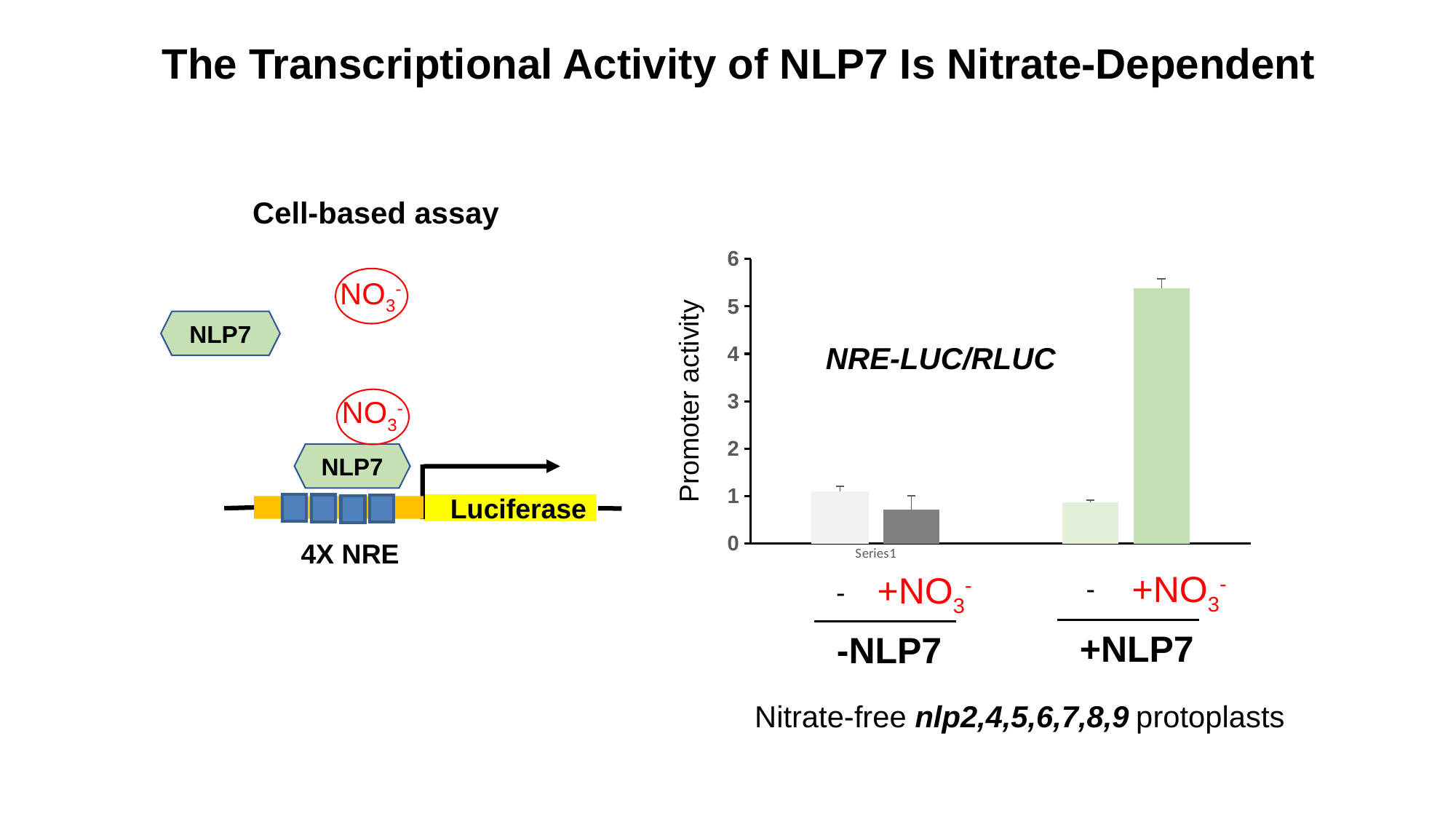
What is the label on the y axis of the chart? Promoter activity Is the promoter activity for +NLP7 without nitrate greater or less than 2? less Is the promoter activity for -NLP7 with +NO3- greater or less than 1? less Is the promoter activity for -NLP7 without nitrate greater or less than 2? less What is the highest value shown on the y axis of the chart? 6 Which is larger: the promoter activity for +NLP7 with +NO3- or for -NLP7 with +NO3-? +NLP7 with +NO3- What kind of chart is shown on the slide? bar chart Which condition has the highest promoter activity? +NLP7 with +NO3- How many bars are plotted in the chart? 4 Which is larger: the promoter activity for -NLP7 without nitrate or for -NLP7 with +NO3-? -NLP7 without nitrate